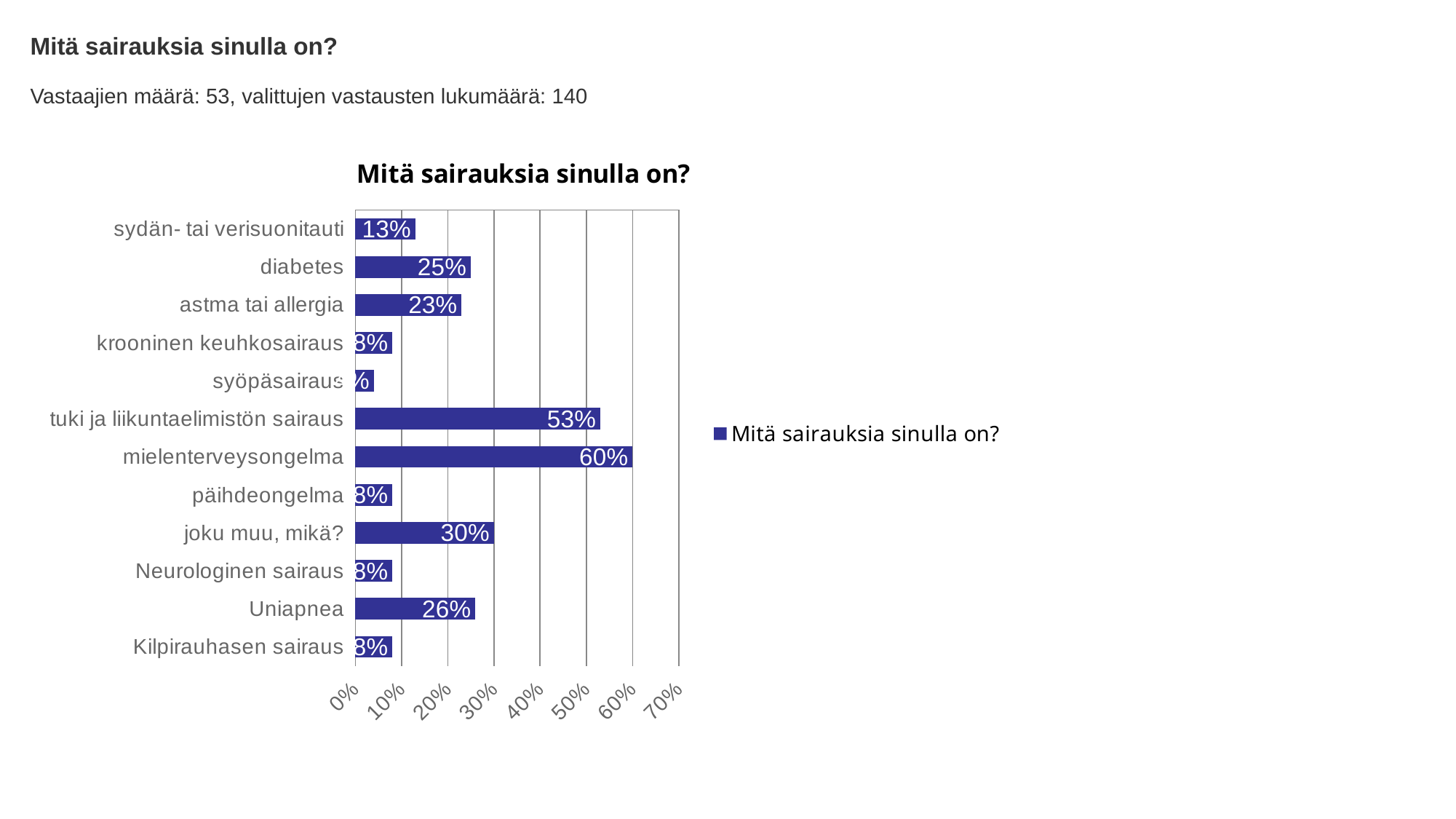
What is the difference between the values for mielenterveysongelma and tuki ja liikuntaelimistön sairaus? 7% How many categories are shown in the chart? 12 What is the value for tuki ja liikuntaelimistön sairaus? 53% Which category has the highest value? mielenterveysongelma Is the value for päihdeongelma greater or less than 10%? less What is the value for Uniapnea? 26% What is the title of the chart? Mitä sairauksia sinulla on? What is the value for mielenterveysongelma? 60% What is the value for joku muu, mikä? 30% Which is larger, the value for diabetes or the value for astma tai allergia? diabetes What is the value for diabetes? 25% What type of chart is shown on the slide? bar chart